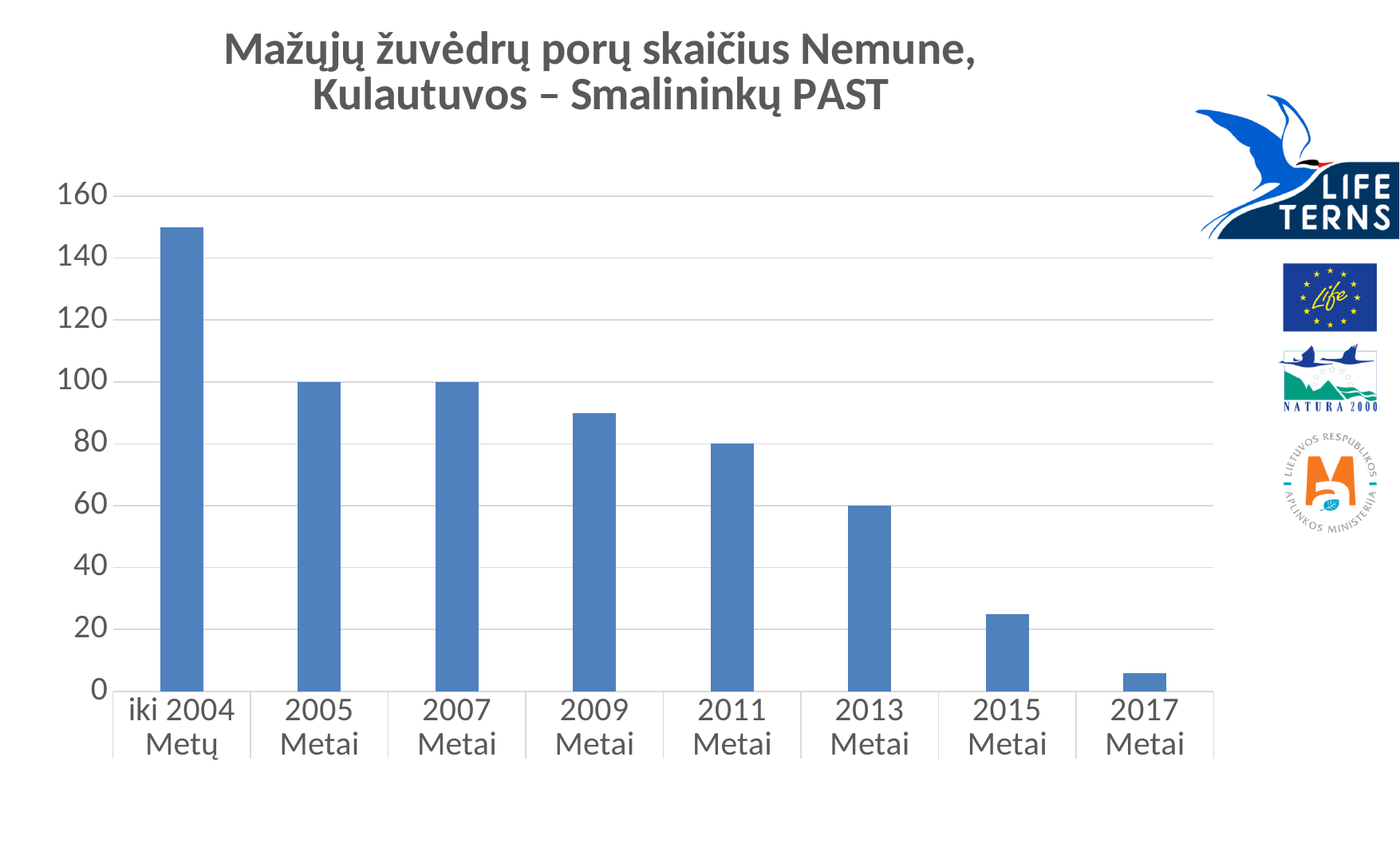
Which category has the lowest value? 2017 Metai What is the value for 2005 Metai? 100 Which category has the highest value? iki 2004 Metų Is the value for 2009 Metai greater or less than 80? greater Which is larger, the value for 2011 Metai or the value for 2013 Metai? 2011 Metai Is the value for 2015 Metai greater or less than 40? less What type of chart is shown on the slide? bar chart Do the values generally rise or fall from left to right along the x axis? fall Is the value for iki 2004 Metų greater or less than 140? greater What is the value for 2013 Metai? 60 How many categories (year groups) are shown on the x axis? 8 What is the value for 2011 Metai? 80